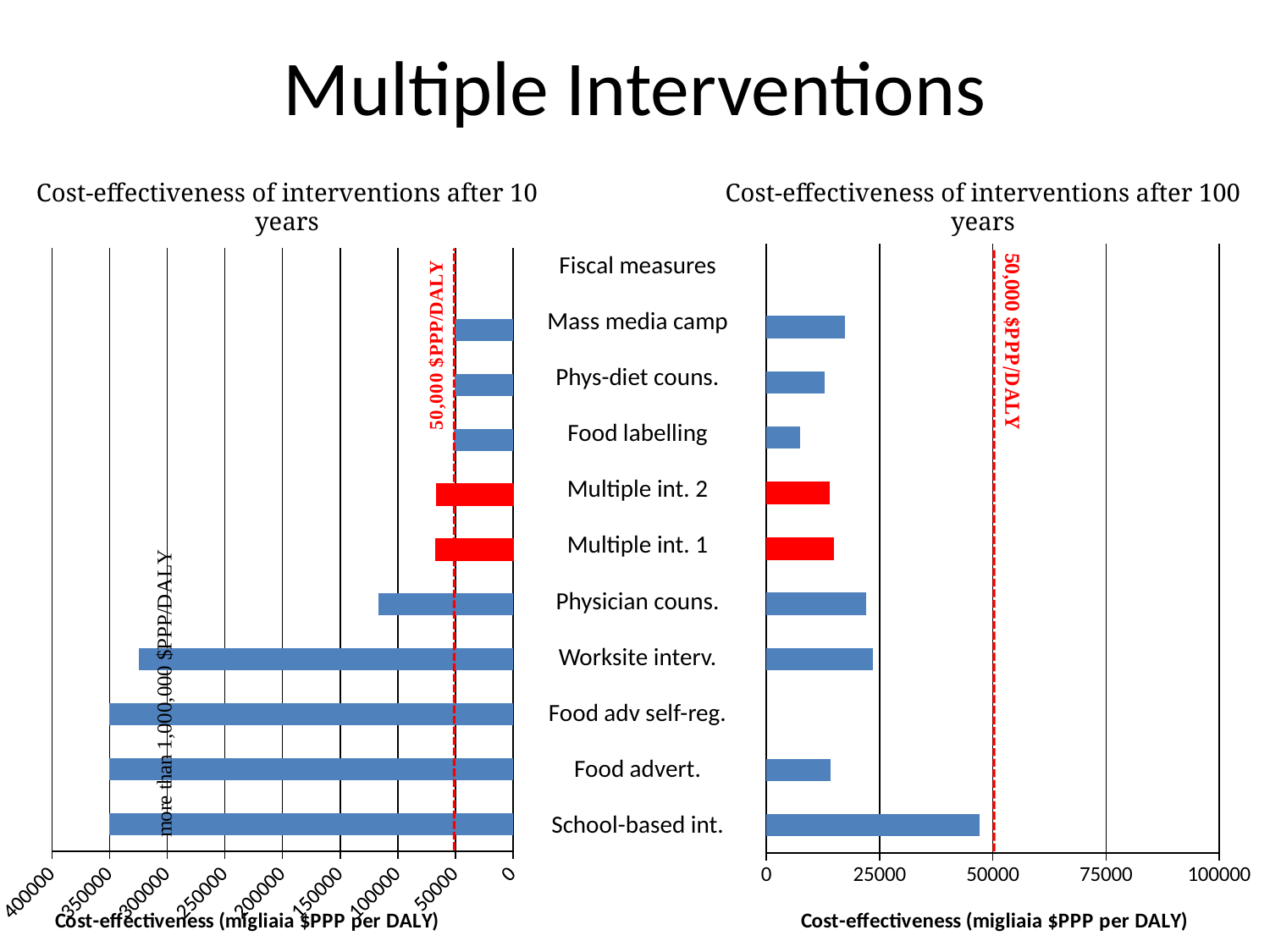
On the 'Cost-effectiveness of interventions after 10 years' chart, which is larger: Physician couns. or Multiple int. 1? Physician couns. On the 'Cost-effectiveness of interventions after 10 years' chart, is the value for Multiple int. 2 greater or less than 50000? greater What value does the red dashed line on the 'Cost-effectiveness of interventions after 100 years' chart mark? 50,000 $PPP/DALY On the 'Cost-effectiveness of interventions after 100 years' chart, which intervention with a visible bar has the lowest value? Food labelling How many intervention categories are listed on the 'Cost-effectiveness of interventions after 100 years' chart? 11 On the 'Cost-effectiveness of interventions after 100 years' chart, which is larger: Worksite interv. or Food labelling? Worksite interv. On the 'Cost-effectiveness of interventions after 100 years' chart, is the value for Physician couns. greater or less than 25000? less On the 'Cost-effectiveness of interventions after 100 years' chart, is the value for School-based int. greater or less than 50000? less On the 'Cost-effectiveness of interventions after 100 years' chart, which intervention has the highest value? School-based int. What kind of chart is the 'Cost-effectiveness of interventions after 10 years' chart? bar chart